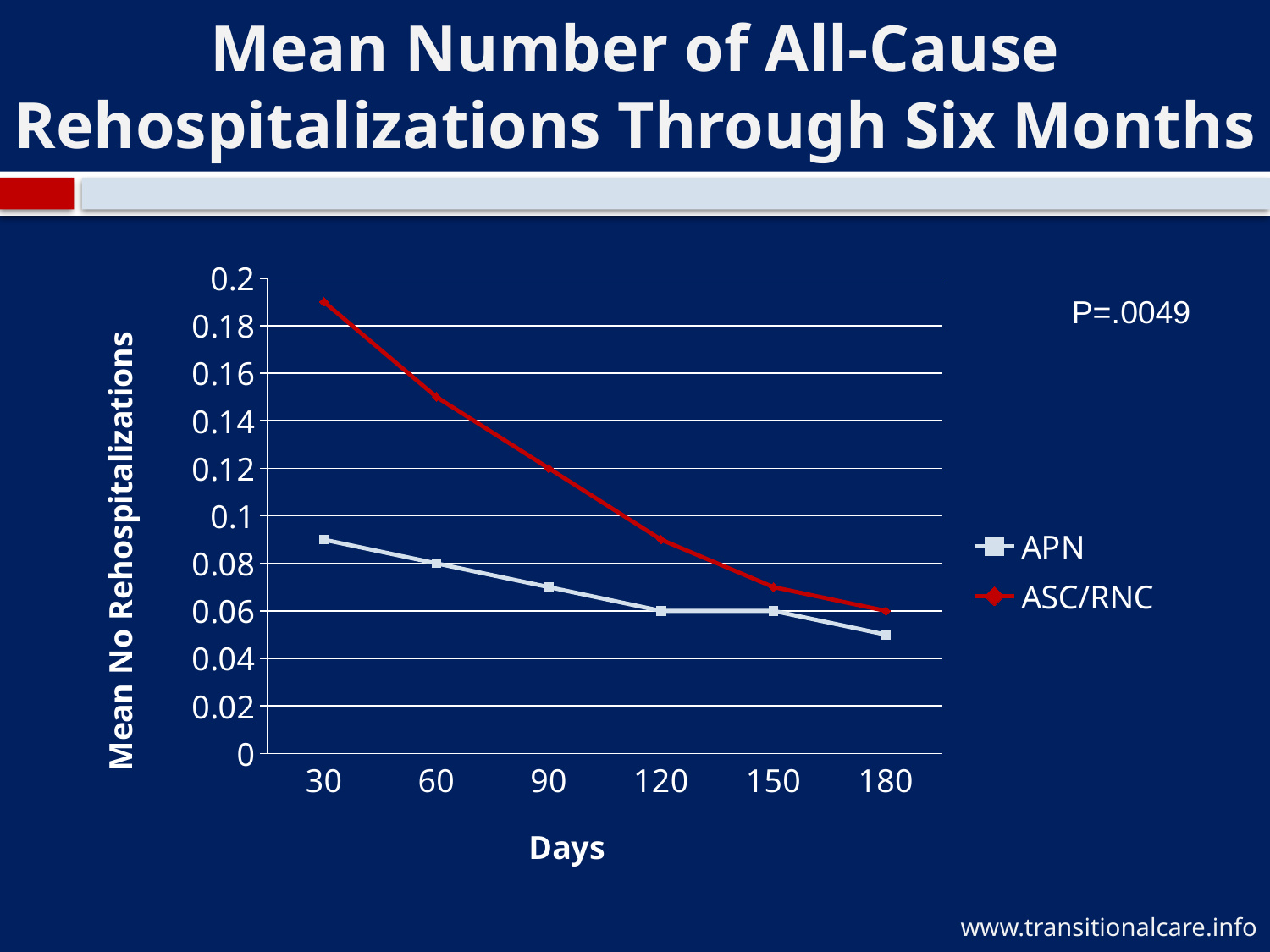
Is the value for APN at 180 days greater or less than 0.06? less How many time points are plotted along the x axis? 6 What is the value for ASC/RNC at 90 days? 0.12 What is the value for APN at 120 days? 0.06 Do the values for ASC/RNC rise or fall as the number of days increases? fall What P value is shown on the chart? P=.0049 Which series has the higher value at 30 days, APN or ASC/RNC? ASC/RNC How many series does the legend list? 2 What is the value for APN at 60 days? 0.08 What kind of chart is shown on the slide? line chart What is the value for ASC/RNC at 180 days? 0.06 Is the value for ASC/RNC at 30 days greater or less than 0.18? greater